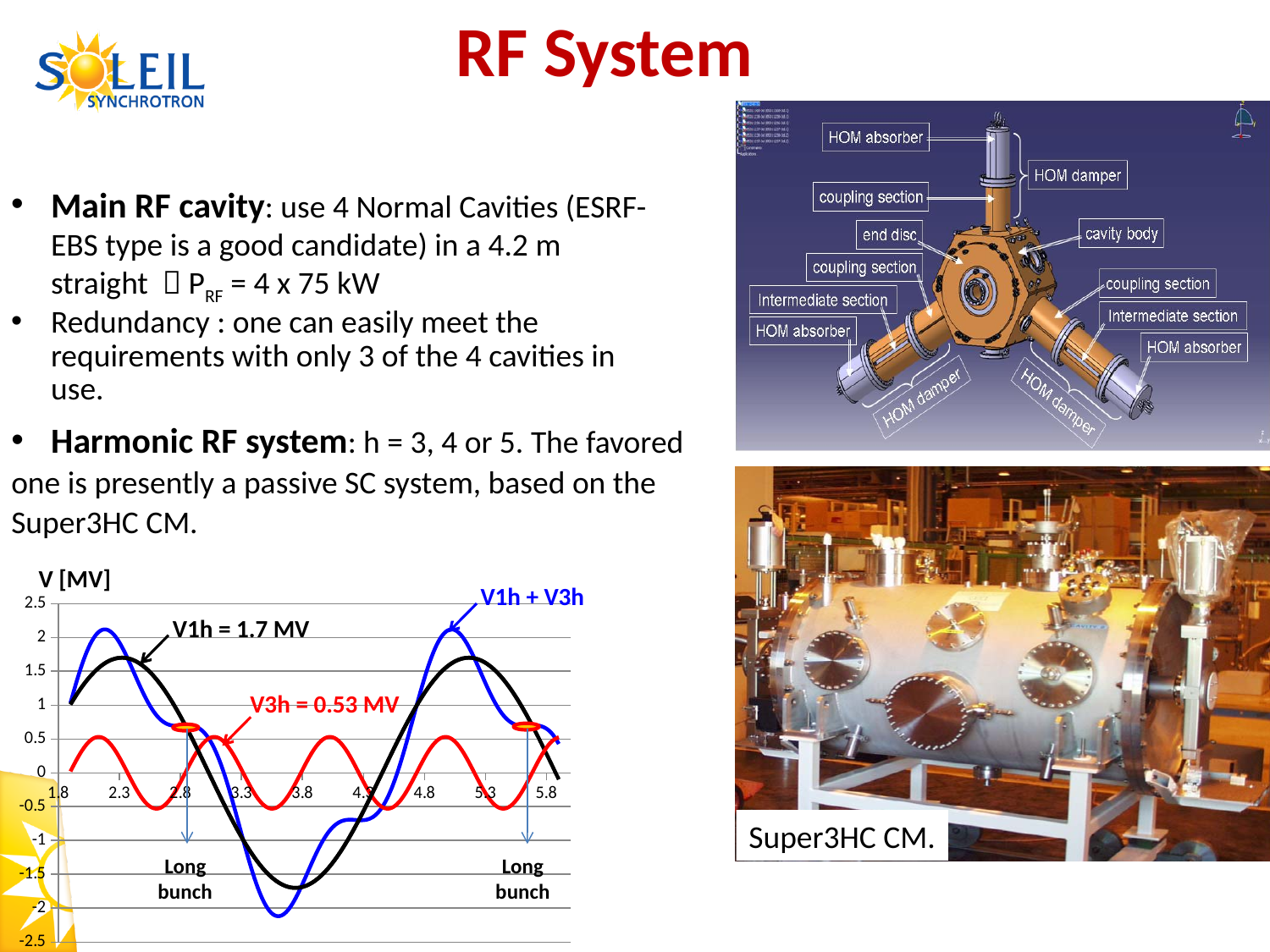
What kind of chart is shown at the bottom left of the slide? line chart In the V [MV] chart, is the peak value of the V1h + V3h curve greater or less than 1.5? greater In the V [MV] chart, which has the larger amplitude, V1h or V3h? V1h In the V [MV] chart, what is the amplitude given for V3h? 0.53 MV In the V [MV] chart, what is the amplitude given for V1h? 1.7 MV How many times does the annotation "Long bunch" appear in the V [MV] chart? 2 What is the label on the vertical axis of the chart at the bottom left? V [MV] How many curves are plotted in the V [MV] chart? 3 In the V [MV] chart, what colour is the V3h curve? red In the V [MV] chart, is the minimum value of the V1h + V3h curve greater or less than -1.5? less In the V [MV] chart, what is the difference between the V1h amplitude and the V3h amplitude? 1.17 MV In the V [MV] chart, is the peak value of the V3h curve greater or less than 1? less